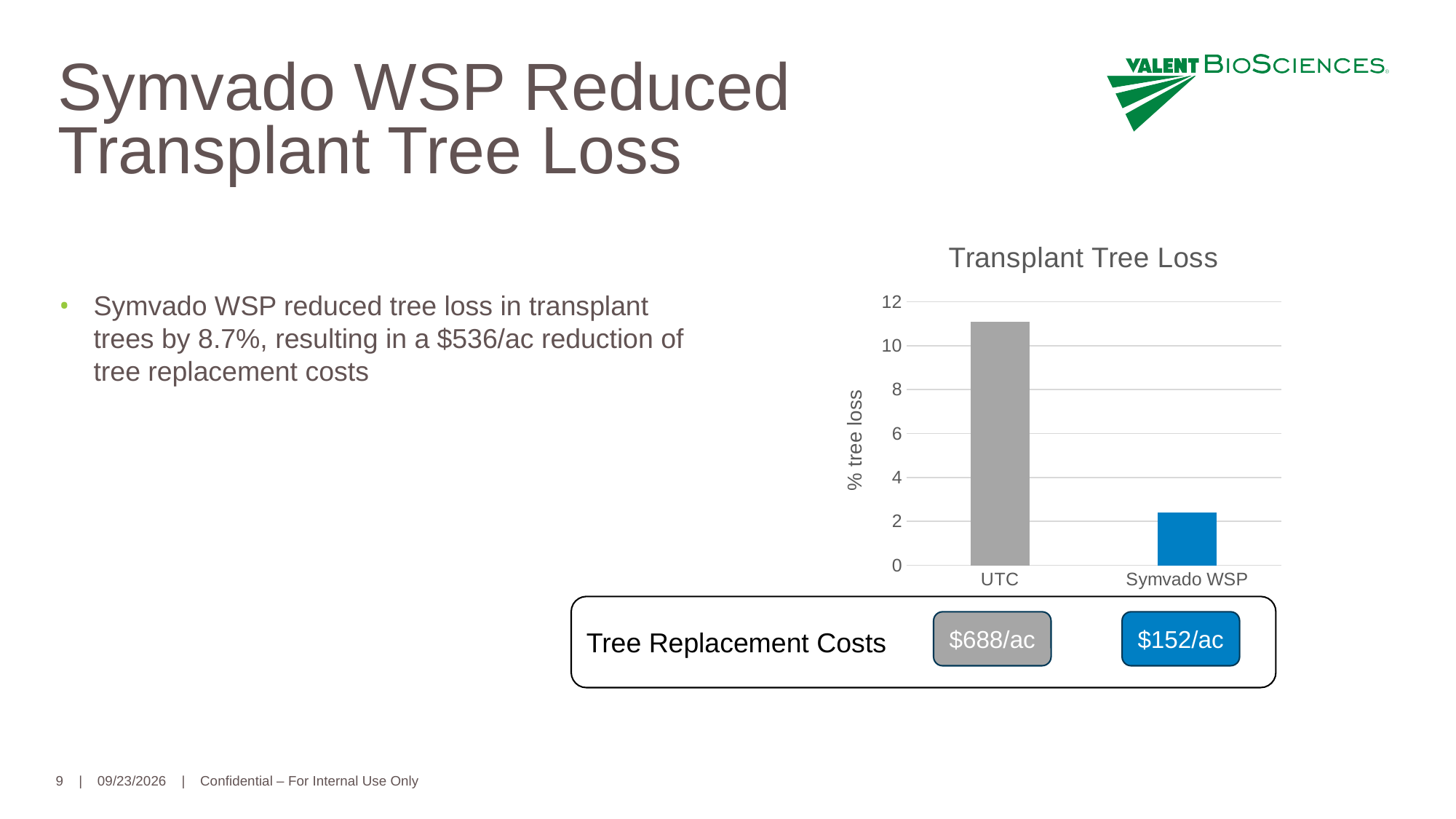
Which has a larger % tree loss, UTC or Symvado WSP? UTC Is the value for UTC greater or less than 10? greater How many categories are plotted in the chart? 2 What is the title of the chart? Transplant Tree Loss What is the label on the vertical axis of the chart? % tree loss Which category has the lowest % tree loss? Symvado WSP Which category has the highest % tree loss? UTC What kind of chart is shown on the slide? bar chart Is the value for UTC greater or less than 12? less Is the value for Symvado WSP greater or less than 4? less